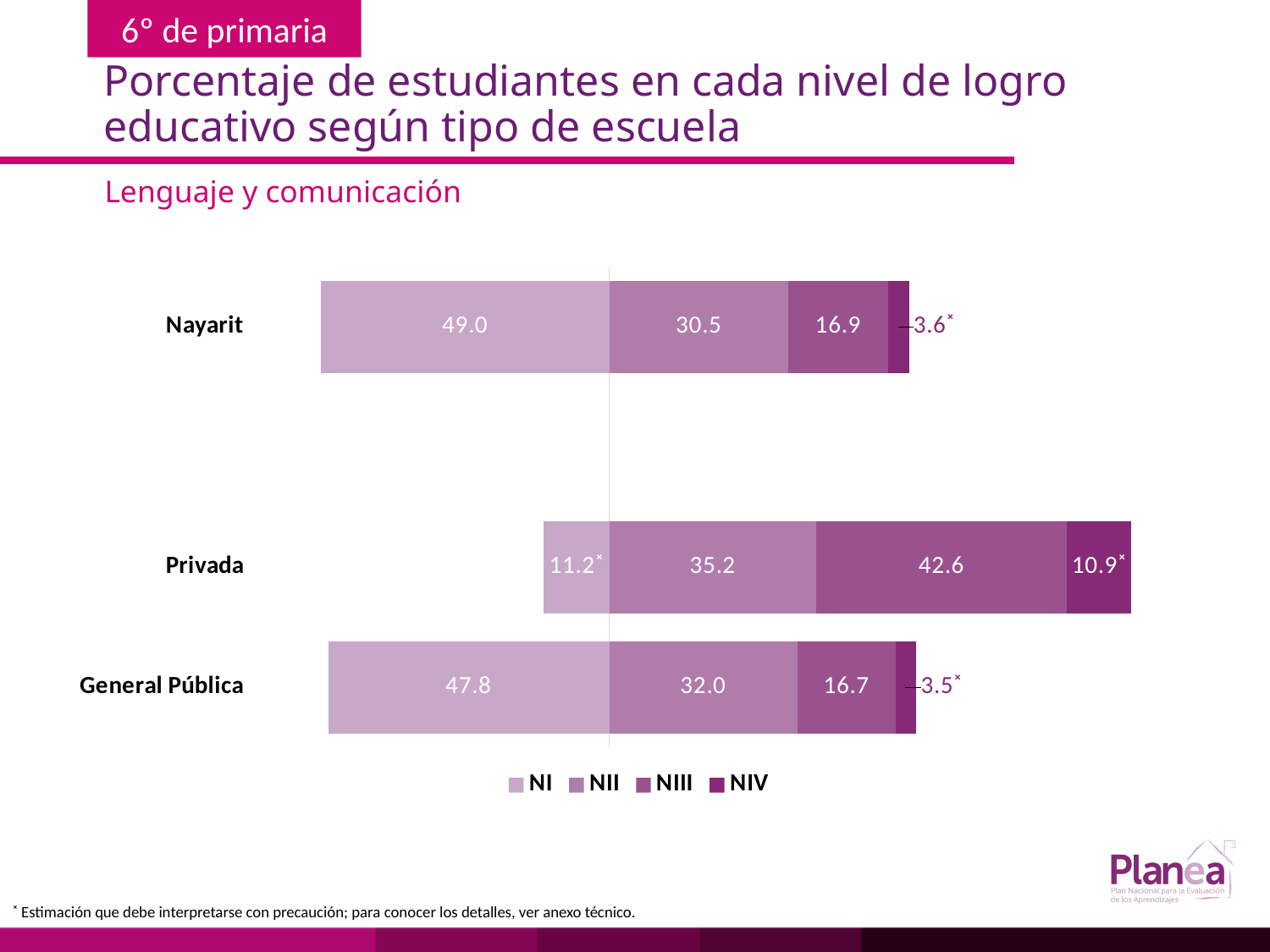
What is the NIII value for Privada? 42.6 Which is larger, the NII value for Privada or the NII value for Nayarit? Privada What is the difference between the NIII values for Privada and Nayarit? 25.7 What kind of chart is shown on the slide? Stacked bar chart What is the NII value for General Pública? 32.0 What is the total of the stacked bar for Privada? 99.9 What is the NIV value for General Pública? 3.5 What is the NI value for Nayarit? 49.0 Which school type has the highest NI value? Nayarit How many school types (categories) are shown in the chart? 3 Which school type has the lowest NIV value? General Pública How many series does the legend list? 4